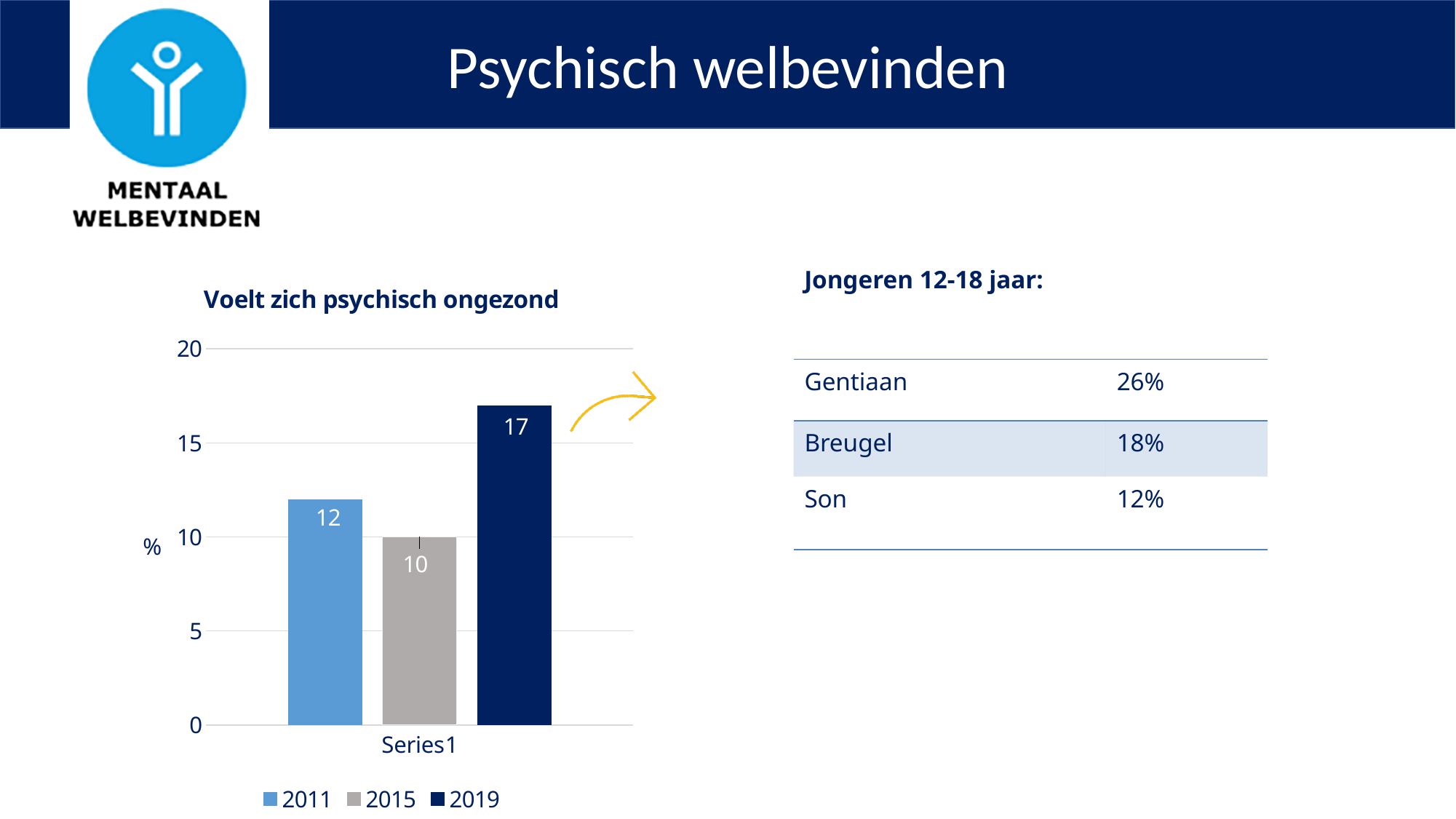
Is the value for 2019 in the chart 'Voelt zich psychisch ongezond' greater or less than 15? greater What is the difference between the 2011 and 2015 values in the chart 'Voelt zich psychisch ongezond'? 2 Which year has the lowest value in the chart 'Voelt zich psychisch ongezond'? 2015 What kind of chart is 'Voelt zich psychisch ongezond'? bar chart What is the value for 2011 in the chart 'Voelt zich psychisch ongezond'? 12 Which year has the highest value in the chart 'Voelt zich psychisch ongezond'? 2019 What is the difference between the 2019 and 2011 values in the chart 'Voelt zich psychisch ongezond'? 5 What is the value for 2015 in the chart 'Voelt zich psychisch ongezond'? 10 In the chart 'Voelt zich psychisch ongezond', which is larger: the value for 2011 or the value for 2015? 2011 How many series does the legend of the chart 'Voelt zich psychisch ongezond' list? 3 What is the title of the chart on the slide? Voelt zich psychisch ongezond What is the value for 2019 in the chart 'Voelt zich psychisch ongezond'? 17